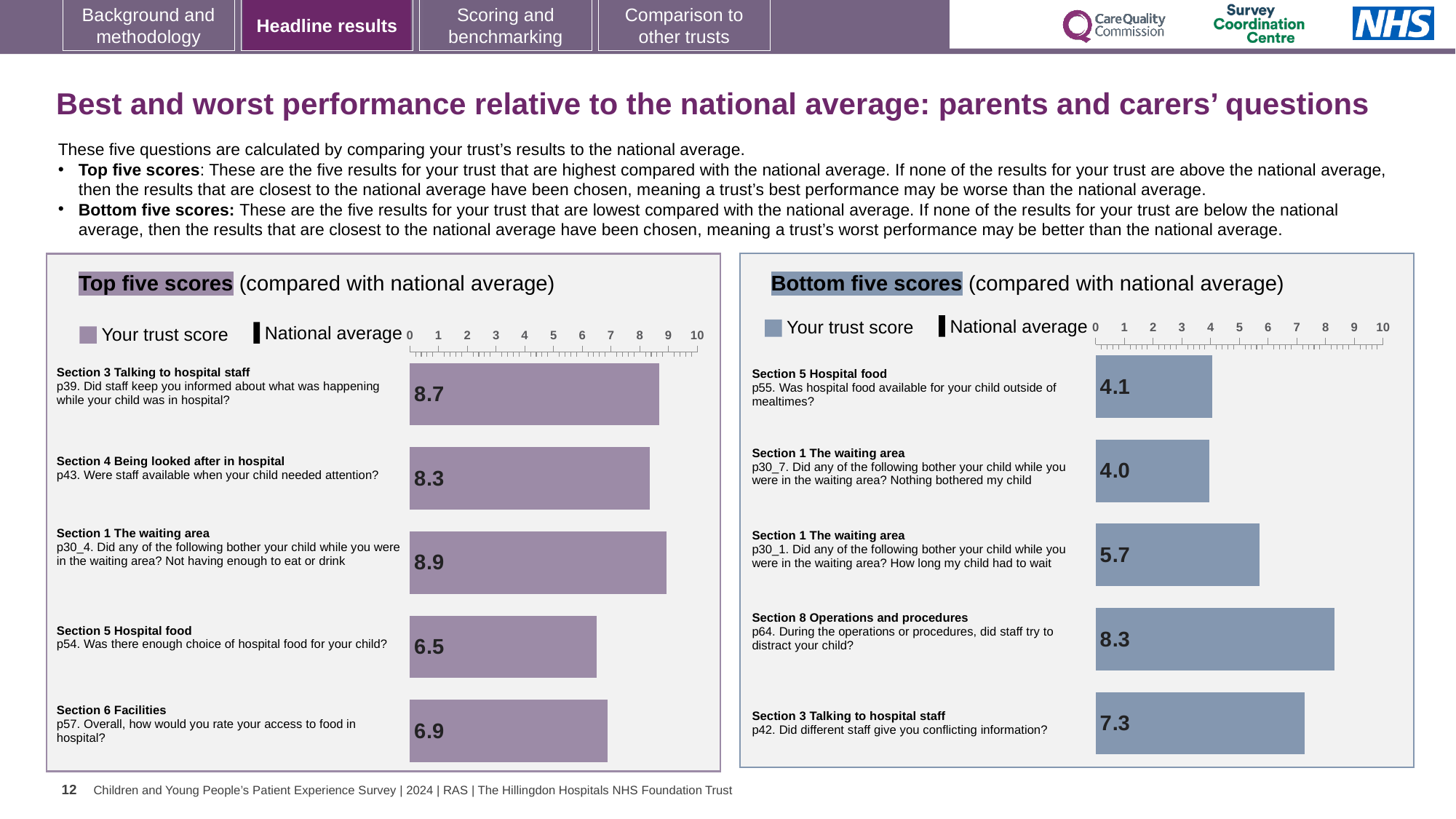
In the Bottom five scores chart, which has the larger trust score: p30_1 (How long my child had to wait) or p42 (Did different staff give you conflicting information?)? p42 In the Top five scores chart, is the trust score for p54 (Was there enough choice of hospital food for your child?) greater or less than 7? less In the Bottom five scores chart, what is the difference between the trust scores for p64 and p55? 4.2 In the Bottom five scores chart, which question has the lowest trust score? p30_7 (Nothing bothered my child) In the Top five scores chart, what is the trust score for p57 (Overall, how would you rate your access to food in hospital?)? 6.9 How many entries does the legend of the Top five scores chart list? 2 In the Top five scores chart, what is the trust score for p39 (Did staff keep you informed about what was happening while your child was in hospital?)? 8.7 In the Top five scores chart, which question has the highest trust score? p30_4 (Not having enough to eat or drink) In the Top five scores chart, what is the difference between the trust scores for p39 and p43? 0.4 In the Bottom five scores chart, what is the trust score for p64 (During the operations or procedures, did staff try to distract your child?)? 8.3 How many questions are plotted in the Bottom five scores chart? 5 What type of chart is the Top five scores chart? Bar chart